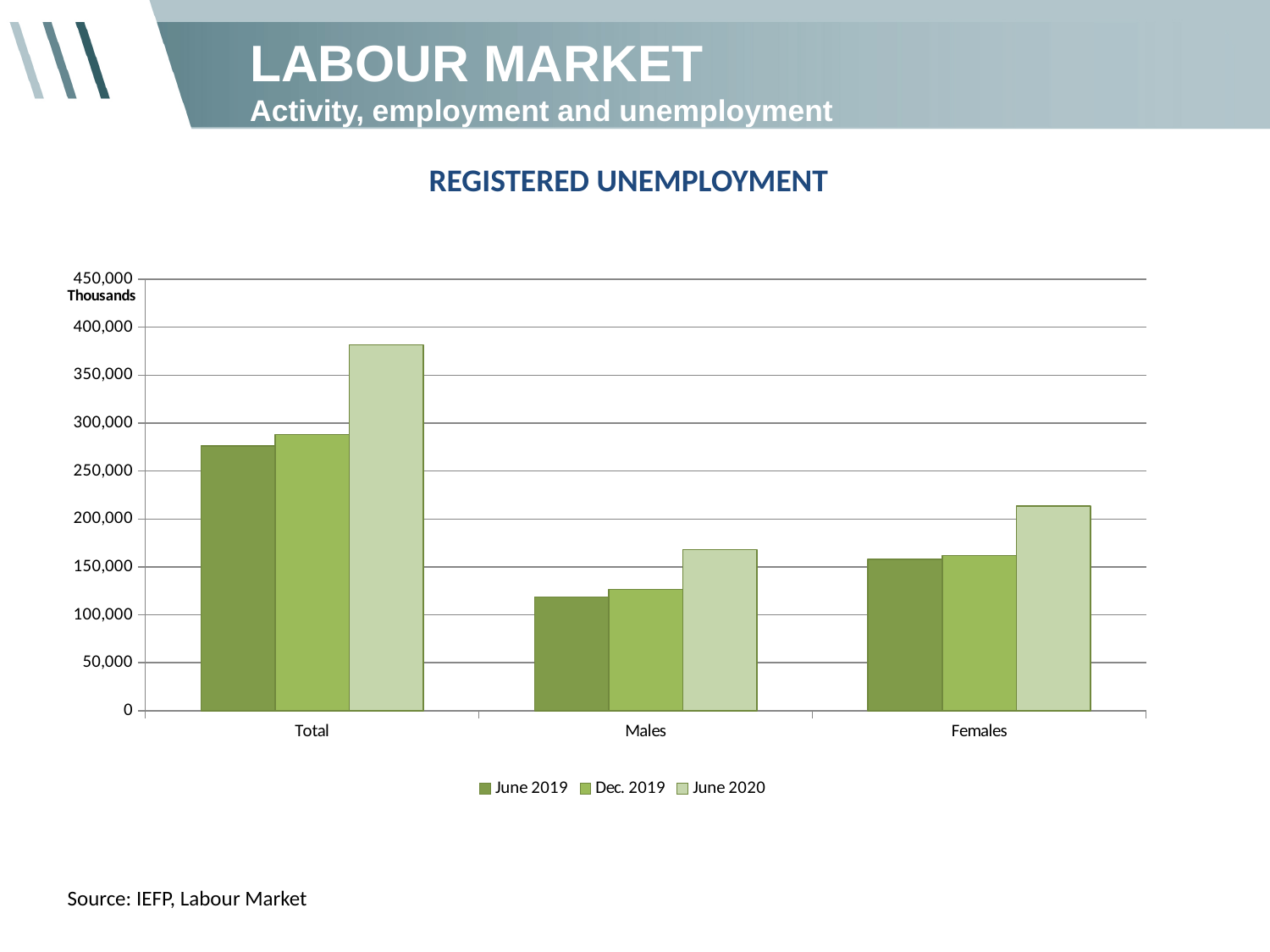
Is the value for Females in June 2020 greater or less than 200,000? greater What is the title of the chart? REGISTERED UNEMPLOYMENT How many categories are shown on the x axis? 3 Is the value for Total in June 2020 greater or less than 350,000? greater Which category has the lowest June 2019 value? Males Is the value for Males in June 2019 greater or less than 150,000? less What kind of chart is shown on the slide? Bar chart For the Total category, do the values rise or fall from June 2019 to June 2020? rise How many series does the legend list? 3 Which category has the highest June 2020 value? Total Which is larger in June 2020, the value for Males or the value for Females? Females